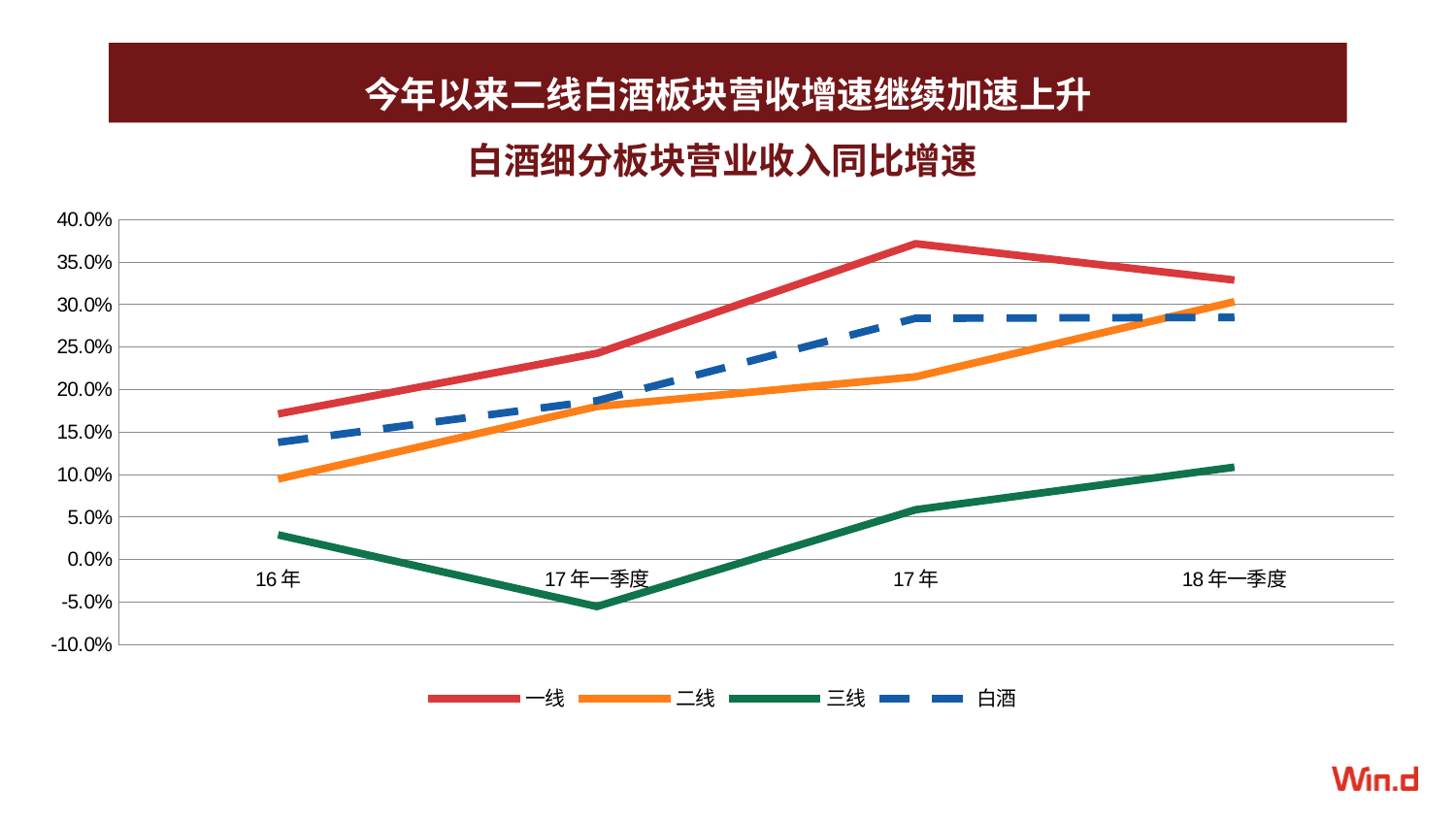
At which category does the 三线 series reach its lowest value? 17年一季度 Which series is drawn with a dashed line? 白酒 What kind of chart is shown on the slide? line chart Does the 二线 series rise or fall from 16年 to 18年一季度? rise Is the value for 二线 at 16年 greater or less than 15.0%? less At 17年, which is larger: the value for 一线 or the value for 二线? 一线 Which series has the highest value at 17年? 一线 How many series does the legend list? 4 Is the value for 三线 at 17年一季度 greater or less than 0.0%? less Is the value for 一线 at 17年 greater or less than 35.0%? greater How many categories are shown on the x axis? 4 Which series has the lowest value at 16年? 三线